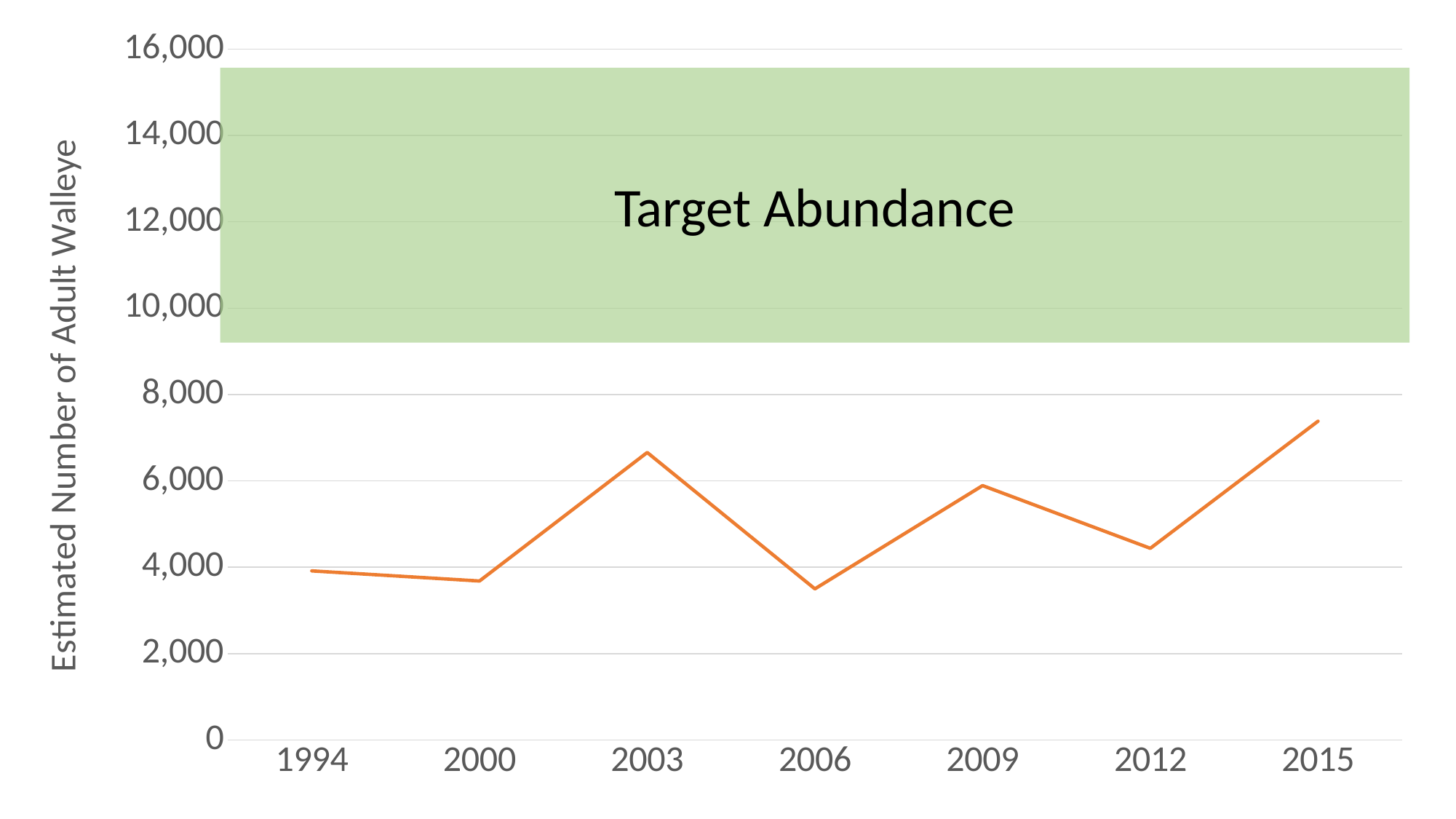
How many years are plotted along the x axis? 7 Is the value for 2000 greater or less than 4,000? less What is the label on the y axis? Estimated Number of Adult Walleye Is the value for 2006 greater or less than 4,000? less Which year has the highest estimated number of adult walleye? 2015 Is the value for 2003 greater or less than 6,000? greater What kind of chart is shown on the slide? line chart Does the line rise or fall from 2012 to 2015? rise Which year has the larger value, 2009 or 2012? 2009 Which year has the larger value, 2003 or 2006? 2003 What does the green shaded band on the chart represent? Target Abundance